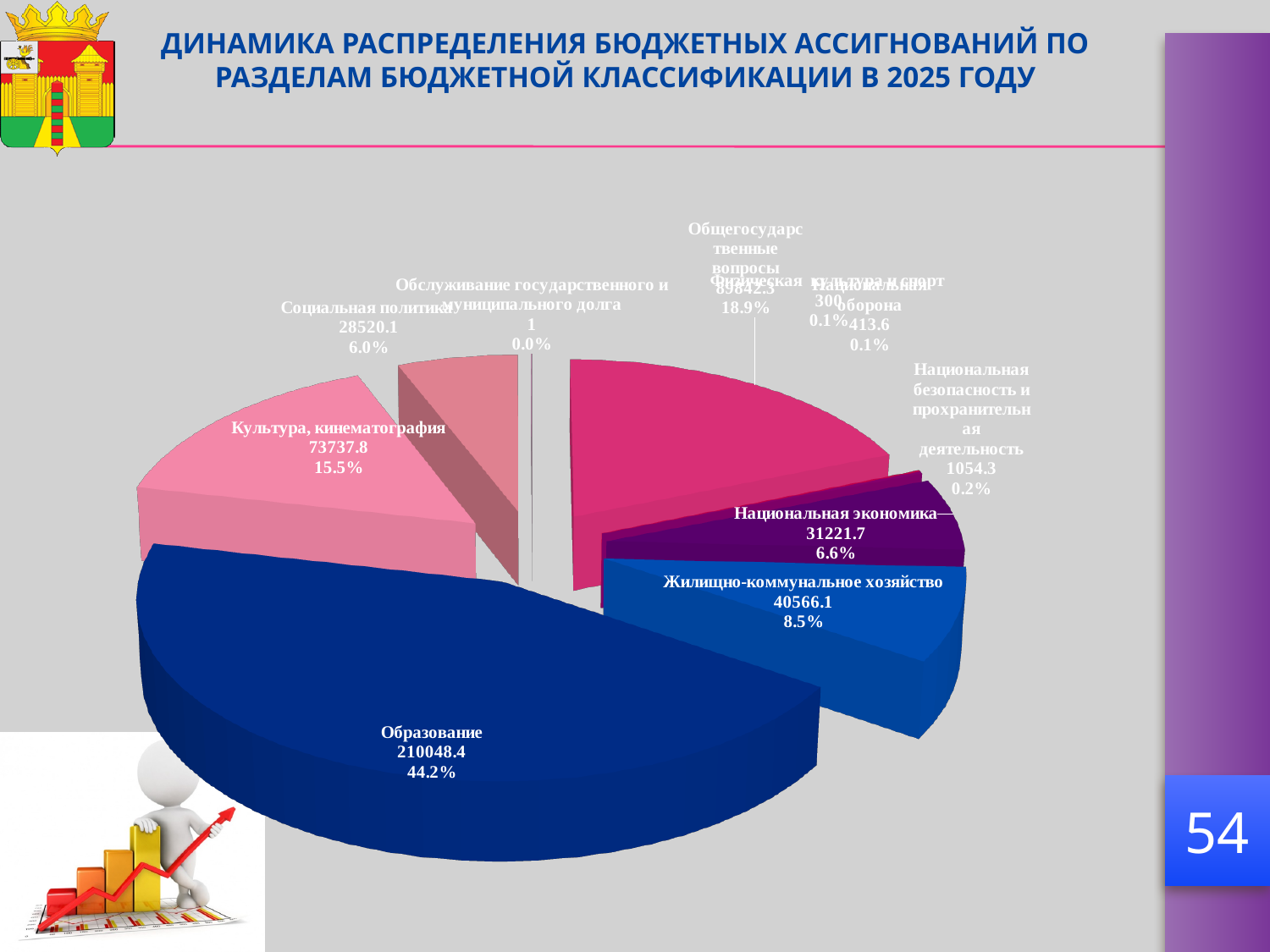
What value is shown for Образование? 210048.4 What share of the pie does Образование take? 44.2% What value is shown for Социальная политика? 28520.1 What is the difference between the values for Образование and Культура, кинематография? 136310.6 What value is shown for Национальная экономика? 31221.7 Which is larger, Жилищно-коммунальное хозяйство or Национальная экономика? Жилищно-коммунальное хозяйство How many categories does the pie chart show? 10 Which category has the largest slice of the pie? Образование What share of the pie does Жилищно-коммунальное хозяйство take? 8.5% What kind of chart is shown on the slide? pie chart What value is shown for Культура, кинематография? 73737.8 Which category has the smallest value in the pie? Обслуживание государственного и муниципального долга